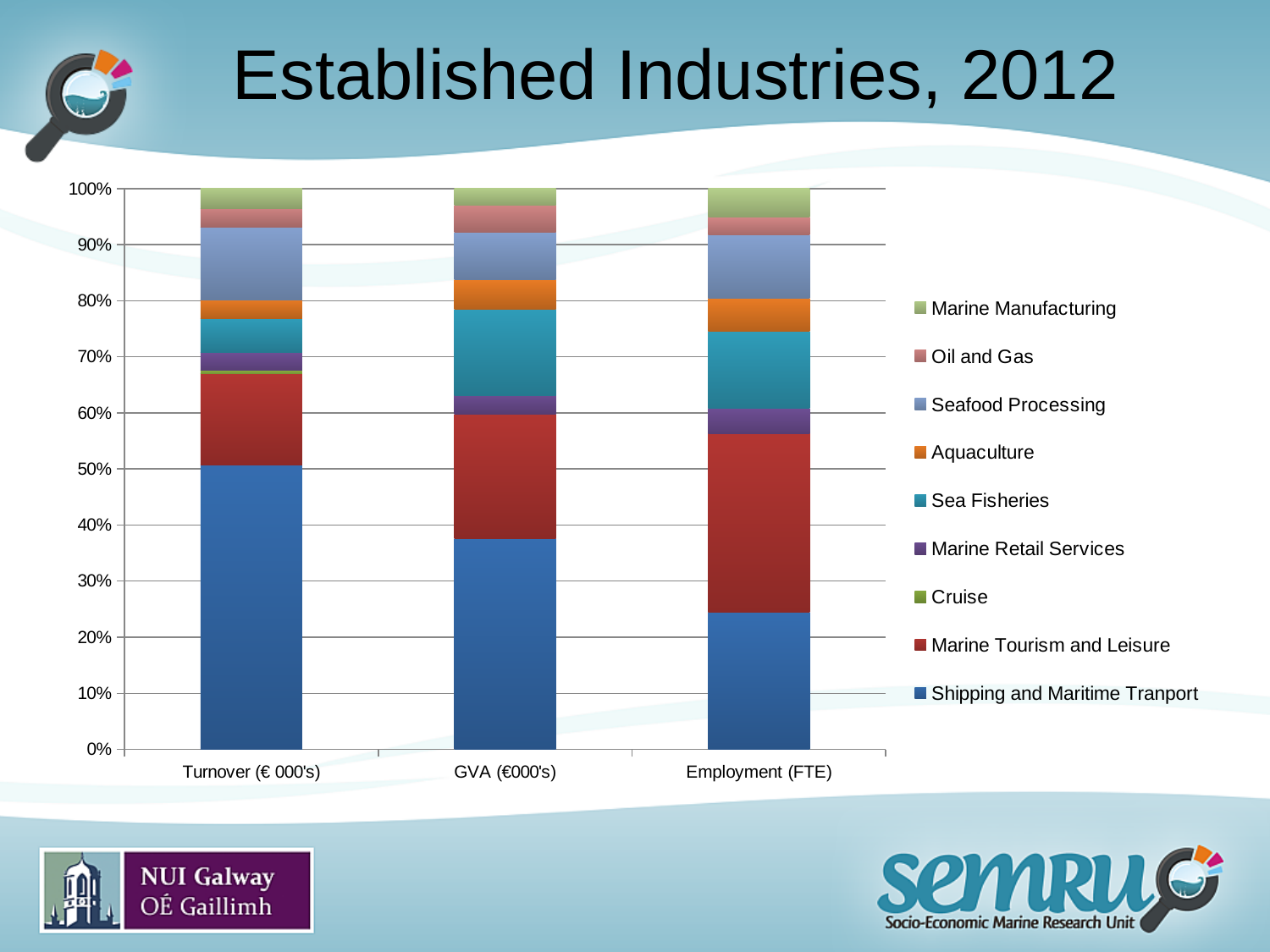
What does each stacked bar total on the y axis? 100% Is the share of Shipping and Maritime Tranport in the GVA (€000's) bar greater or less than 30%? greater Does the share of Shipping and Maritime Tranport rise or fall moving from Turnover to GVA to Employment? fall How many categories are shown on the x axis? 3 Is the share of Marine Tourism and Leisure larger in the Turnover (€ 000's) bar or the Employment (FTE) bar? Employment (FTE) Is the share of Shipping and Maritime Tranport larger in the Turnover (€ 000's) bar or the GVA (€000's) bar? Turnover (€ 000's) Which series is listed at the bottom of the legend? Shipping and Maritime Tranport What kind of chart is shown on the slide? Stacked bar chart How many series does the legend list? 9 Is the share of Shipping and Maritime Tranport in the Employment (FTE) bar greater or less than 30%? less Is the share of Shipping and Maritime Tranport in the Employment (FTE) bar greater or less than 20%? greater What is the title of the chart? Established Industries, 2012